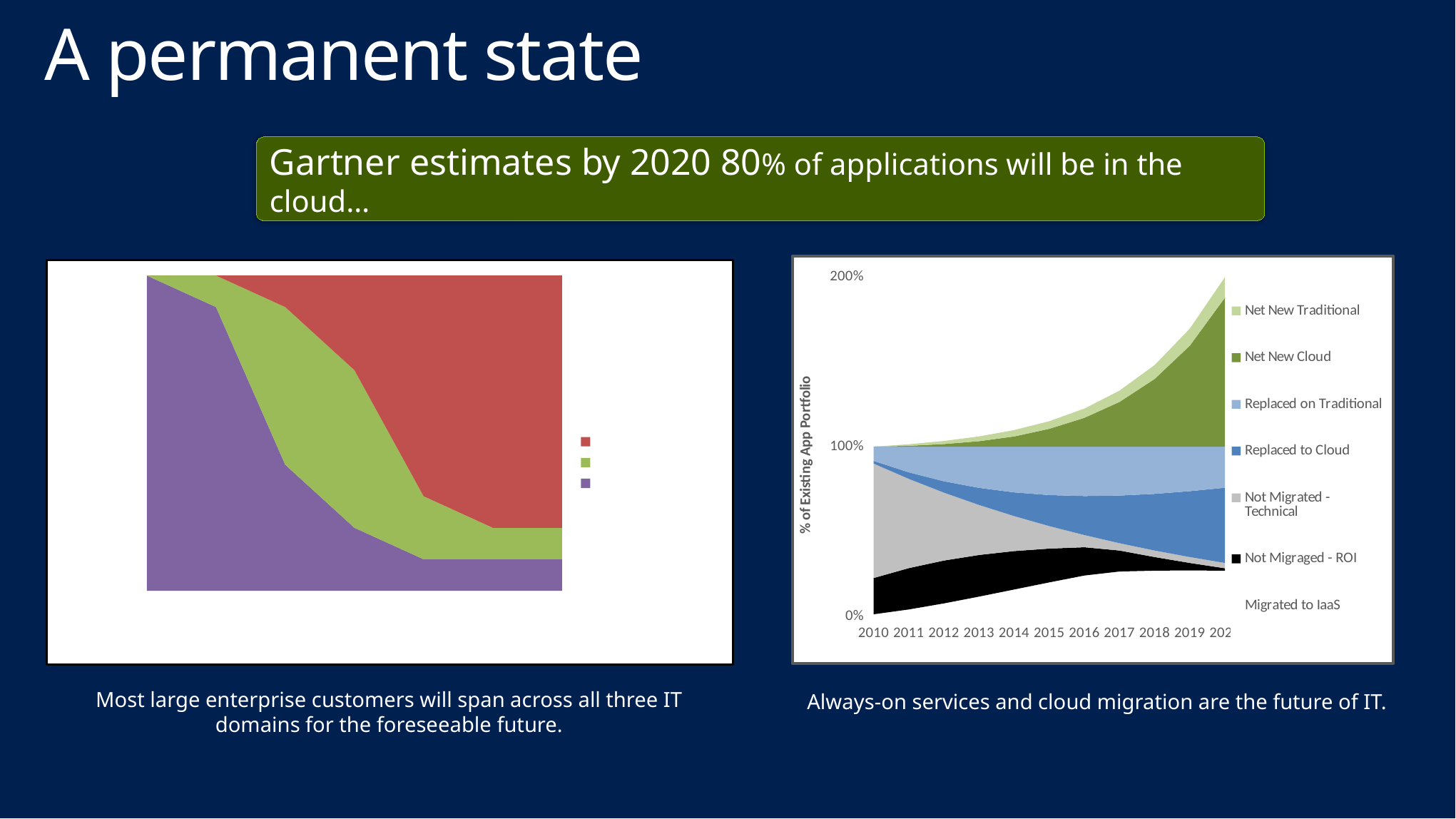
In the chart on the right, how many series does the legend list? 7 In the chart on the right, what is the first year shown on the x axis? 2010 In the chart on the right, what is the title of the y axis? % of Existing App Portfolio In the chart on the left, does the purple area rise or fall from left to right? fall In the chart on the left, how many series does the legend show? 3 In the chart on the right, what is the highest value labelled on the y axis? 200% In the chart on the right, does the total height of the stacked areas rise or fall from 2010 to 2020? rise What kind of chart is the chart on the right of the slide? area chart In the chart on the left, does the red area grow or shrink from left to right? grow What kind of chart is the chart on the left of the slide? area chart In the chart on the right, is the total of all stacked areas in 2019 greater or less than 100%? greater In the chart on the right, which legend entry is listed first? Net New Traditional